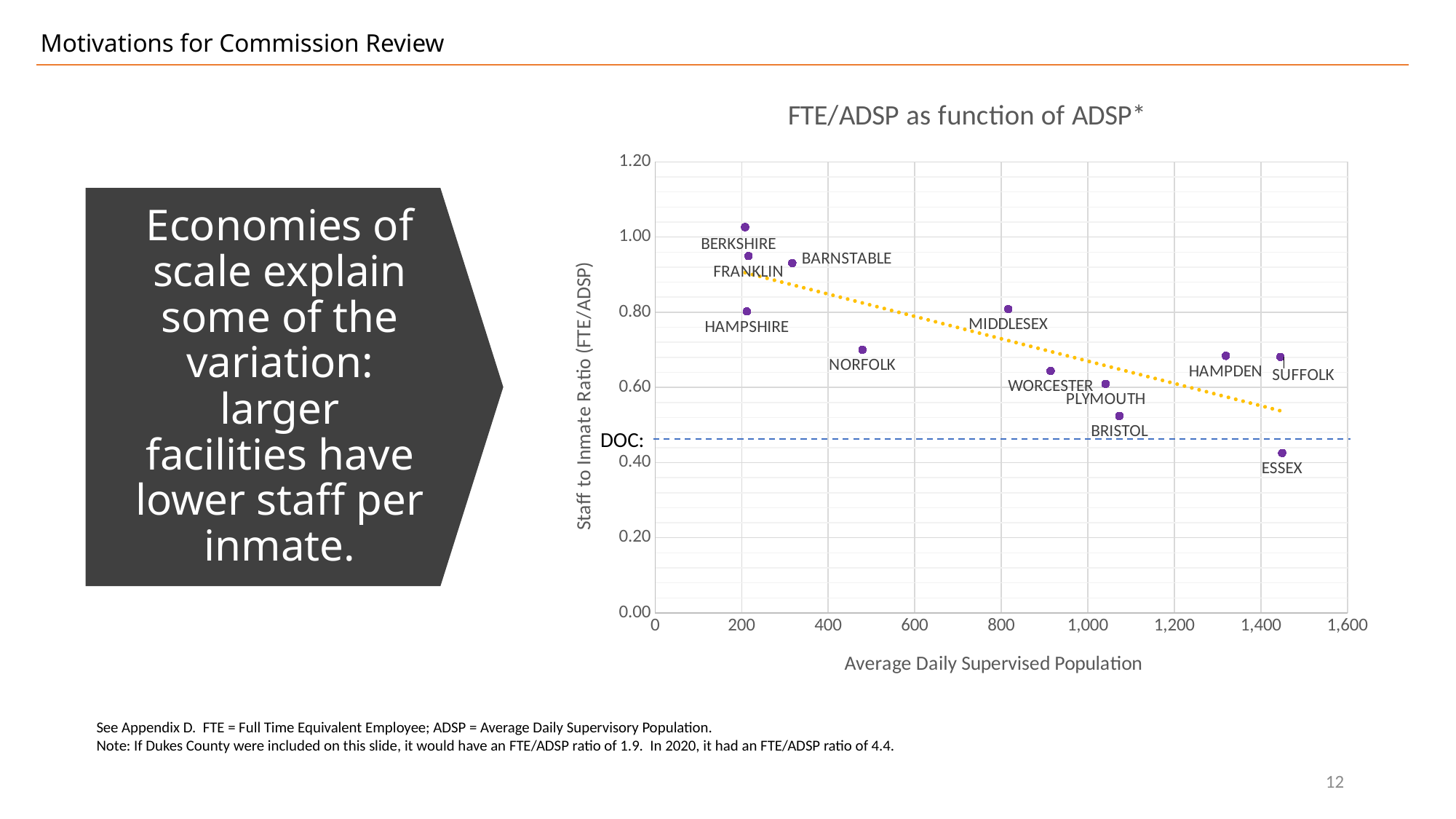
Does the dotted trend line rise or fall as Average Daily Supervised Population increases? Fall Is the staff to inmate ratio for NORFOLK greater or less than 0.60? greater Is the staff to inmate ratio for BRISTOL greater or less than 0.60? less Is the staff to inmate ratio for ESSEX greater or less than 0.60? less How many labeled facilities are plotted on the chart? 12 What is the label of the x axis? Average Daily Supervised Population Which facility has the lowest staff to inmate ratio? ESSEX Which has the higher staff to inmate ratio, MIDDLESEX or WORCESTER? MIDDLESEX What is the title of the chart? FTE/ADSP as function of ADSP* Which facility has the highest staff to inmate ratio? BERKSHIRE What kind of chart is shown on the slide? Scatter chart